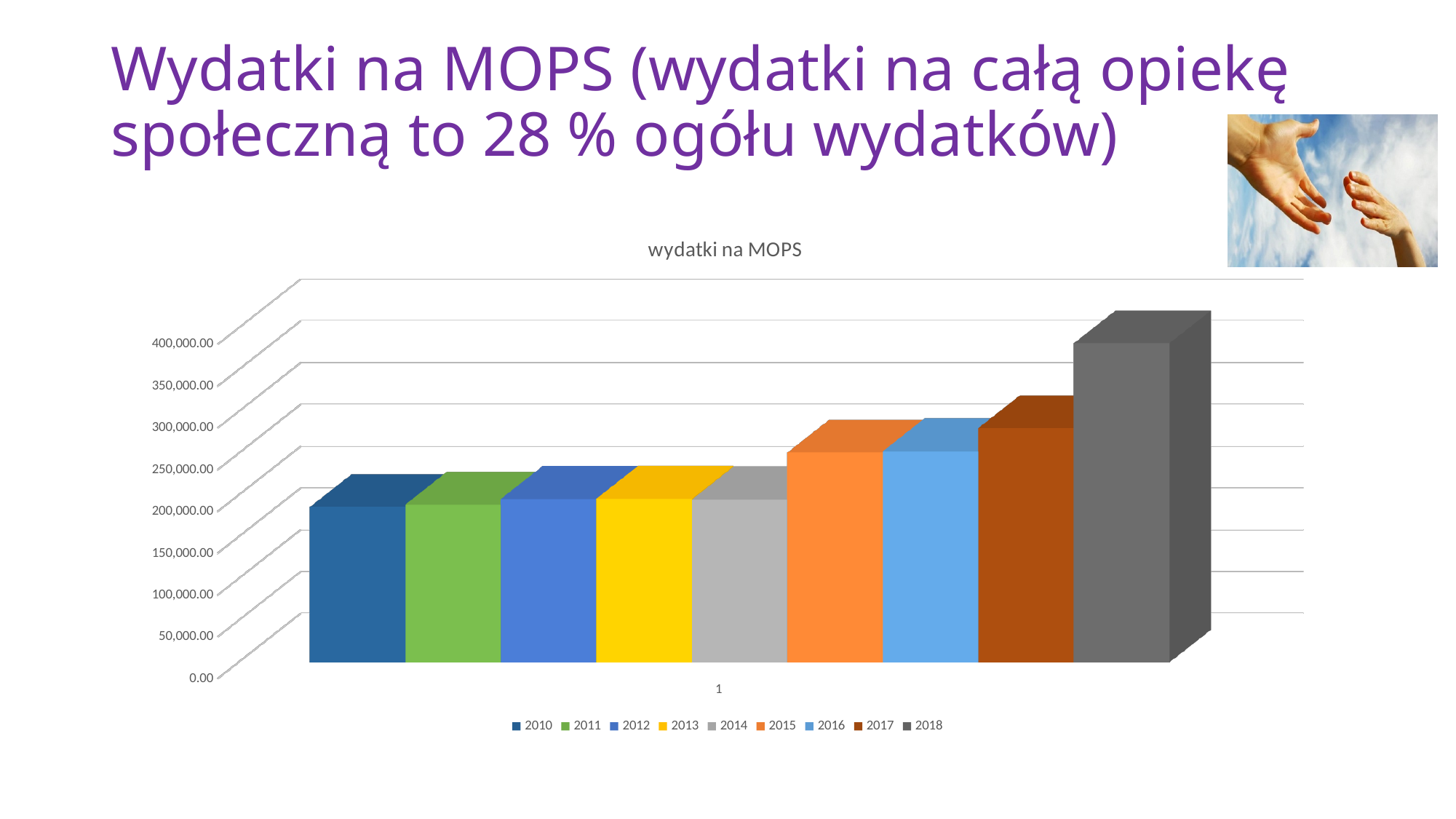
How many series does the chart legend list? 9 What is the title of the chart? wydatki na MOPS Is the value for 2018 greater or less than 350,000.00? greater Which is larger, the value for 2017 or the value for 2014? 2017 Which year has the highest value in the chart? 2018 Which is larger, the value for 2018 or the value for 2010? 2018 Is the value for 2015 greater or less than 300,000.00? less Is the value for 2017 greater or less than 250,000.00? greater Do the values generally rise or fall from 2010 to 2018? rise What colour is the bar for 2013? yellow What kind of chart is shown on the slide? bar chart